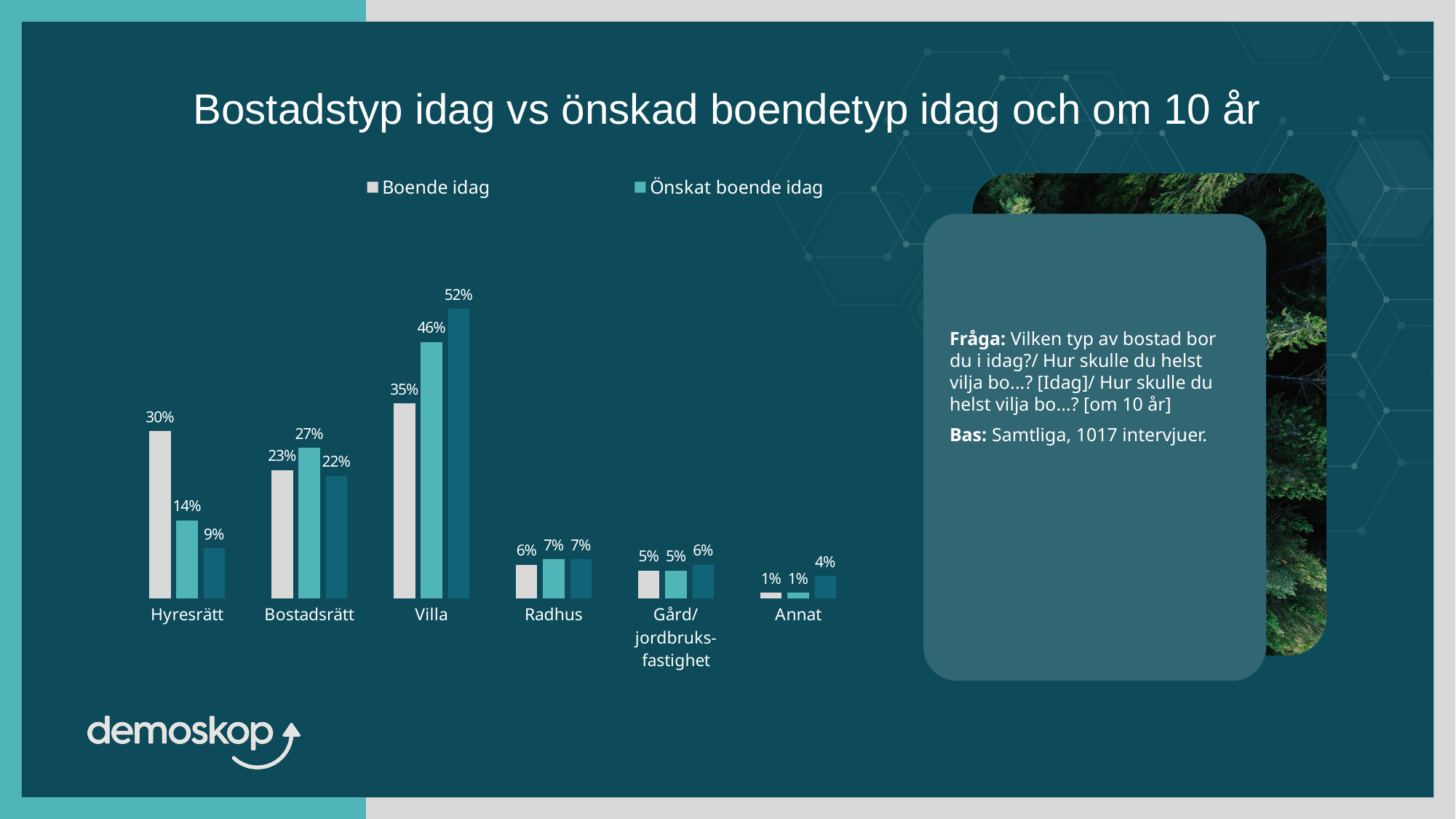
What is the difference between the Boende idag and Önskat boende idag values for Hyresrätt? 16% What is the difference between the Önskat boende idag and Boende idag values for Villa? 11% Which category has the highest value in the Boende idag series? Villa What is the value for Radhus in the Boende idag series? 6% What is the value for Villa in the Boende idag series? 35% What is the value for Bostadsrätt in the Önskat boende idag series? 27% Which is larger for Bostadsrätt: the Boende idag value or the Önskat boende idag value? Önskat boende idag How many categories are shown on the x axis? 6 What is the title of the chart? Bostadstyp idag vs önskad boendetyp idag och om 10 år Which category has the lowest value in the Önskat boende idag series? Annat What kind of chart is shown on the slide? Bar chart What is the value for Hyresrätt in the Önskat boende idag series? 14%